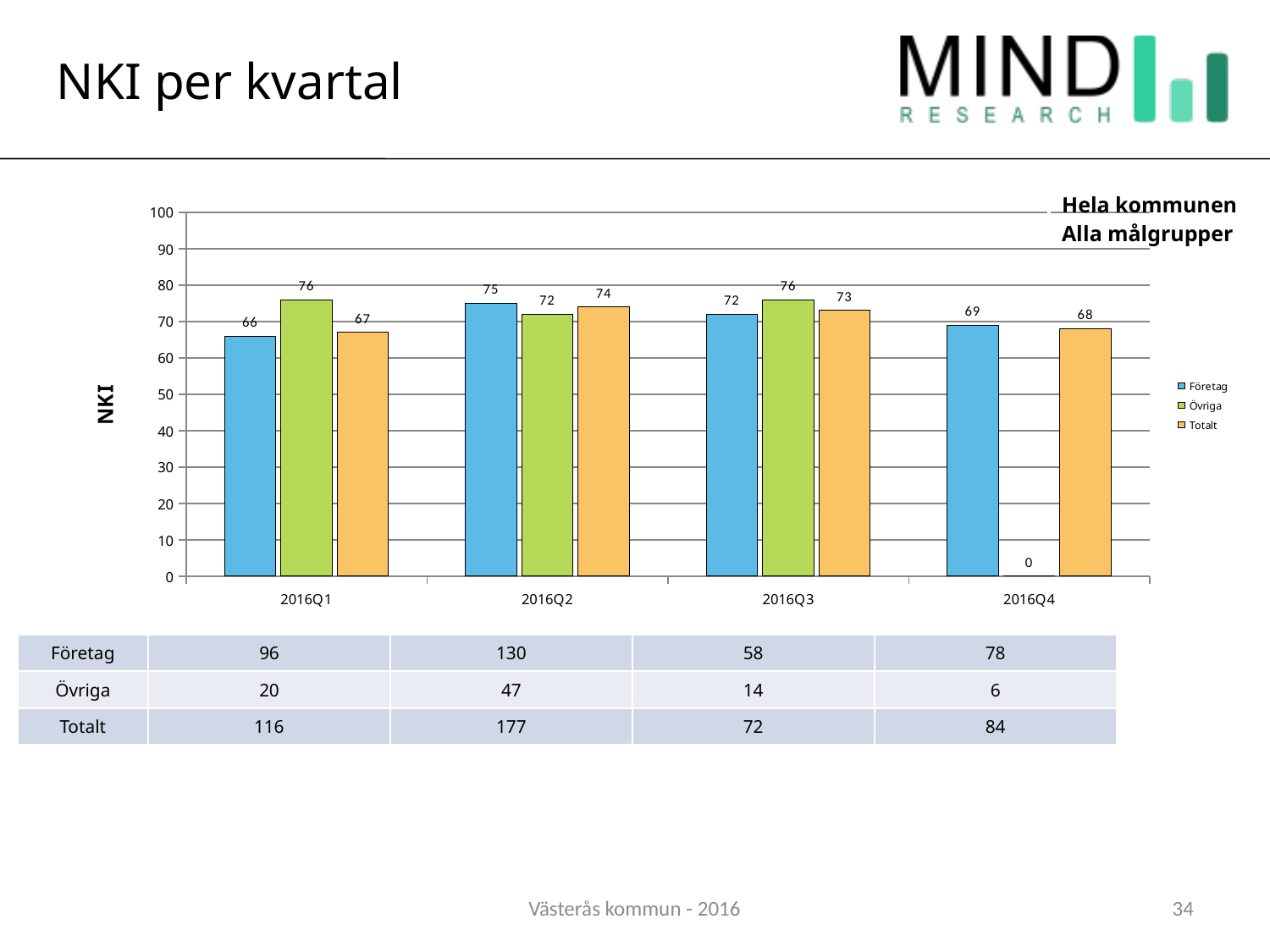
What kind of chart is shown on the slide? Bar chart What is the NKI value for Företag in 2016Q1? 66 What is the label on the vertical axis of the chart? NKI In which quarter is the Totalt NKI value lowest? 2016Q1 What is the NKI value for Övriga in 2016Q2? 72 Which is larger in 2016Q3: the Företag NKI value or the Övriga NKI value? Övriga What is the difference between the Övriga and Företag NKI values in 2016Q1? 10 How many series does the chart legend list? 3 What is the NKI value for Övriga in 2016Q4? 0 How many quarters are shown on the x axis of the chart? 4 In which quarter is the Företag NKI value highest? 2016Q2 What is the NKI value for Totalt in 2016Q3? 73